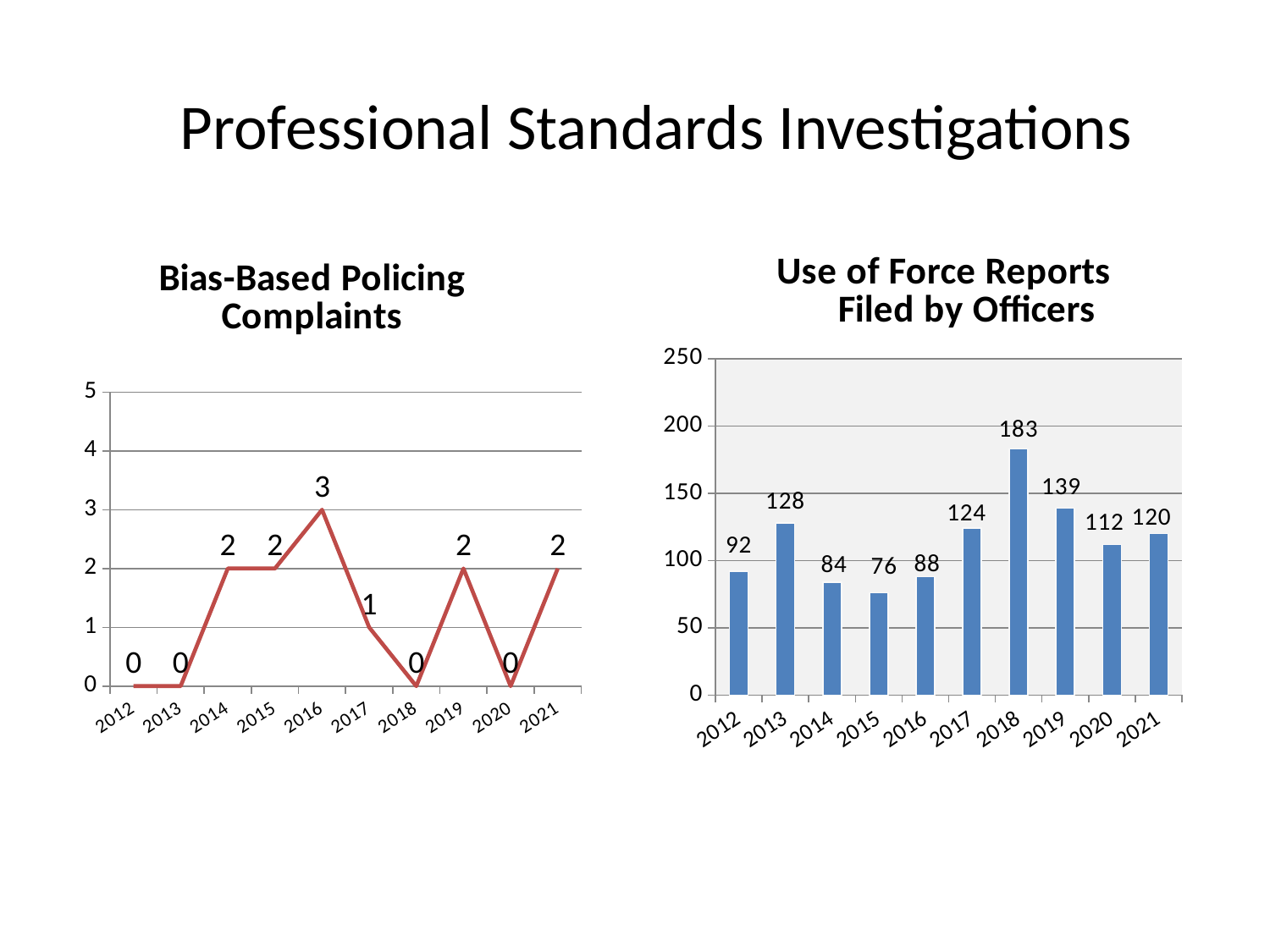
What kind of chart is the Use of Force Reports Filed by Officers chart? bar chart In the Bias-Based Policing Complaints chart, what is the value for 2016? 3 In the Bias-Based Policing Complaints chart, how many years are plotted? 10 In the Bias-Based Policing Complaints chart, what is the value for 2017? 1 What kind of chart is the Bias-Based Policing Complaints chart? line chart In the Use of Force Reports Filed by Officers chart, what is the value for 2015? 76 In the Use of Force Reports Filed by Officers chart, which year has the lowest value? 2015 In the Use of Force Reports Filed by Officers chart, do the values rise or fall from 2018 to 2020? fall In the Use of Force Reports Filed by Officers chart, which is larger, the value for 2013 or the value for 2017? 2013 In the Use of Force Reports Filed by Officers chart, what is the value for 2018? 183 In the Bias-Based Policing Complaints chart, which year has the highest value? 2016 In the Use of Force Reports Filed by Officers chart, what is the difference between the values for 2018 and 2019? 44